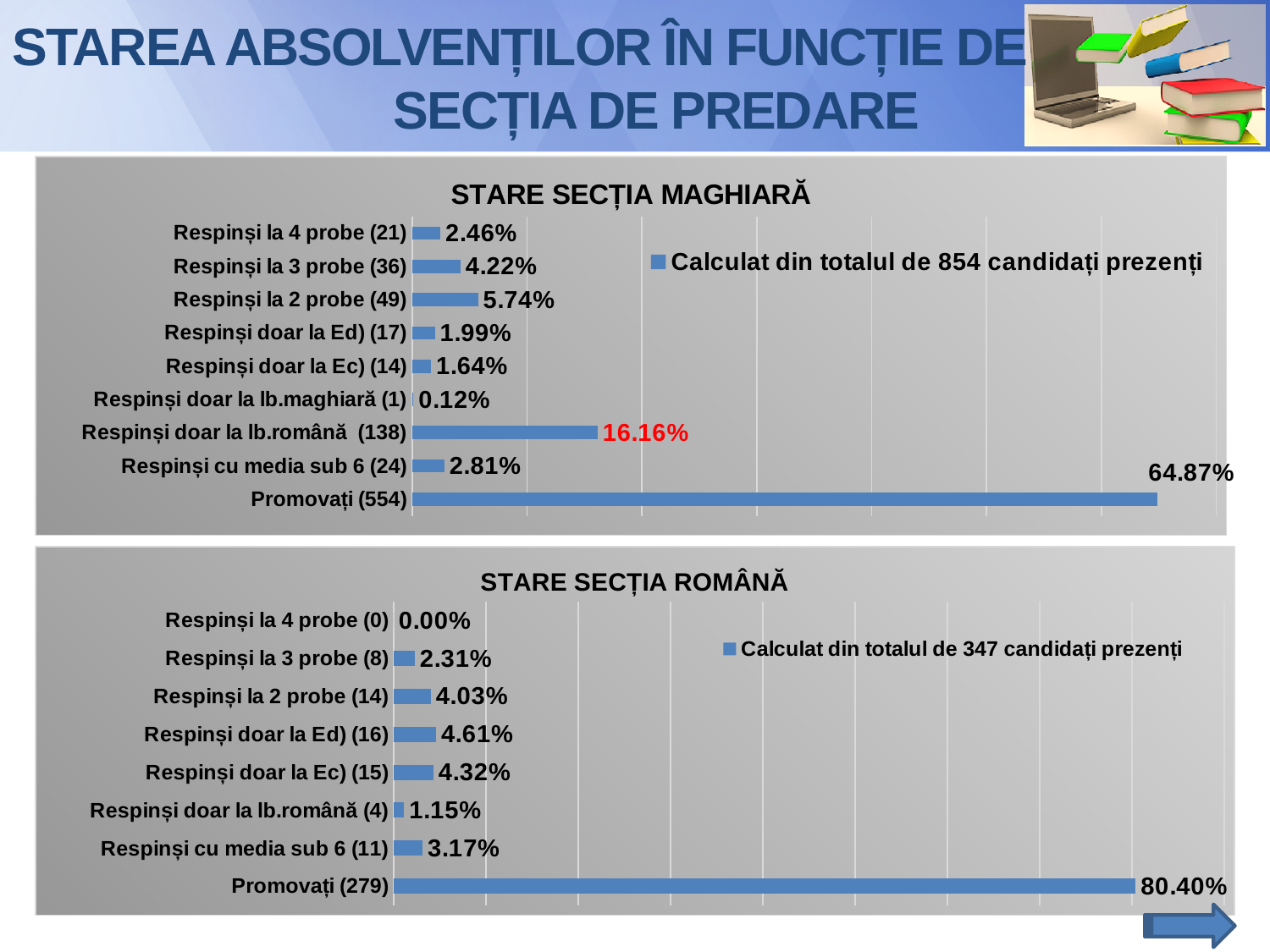
In the STARE SECȚIA ROMÂNĂ chart, which is larger: Respinși doar la Ec) (15) or Respinși cu media sub 6 (11)? Respinși doar la Ec) (15) In the STARE SECȚIA MAGHIARĂ chart, what does the legend entry say? Calculat din totalul de 854 candidați prezenți What type of chart is the STARE SECȚIA ROMÂNĂ chart? Bar chart In the STARE SECȚIA ROMÂNĂ chart, what is the value for Promovați (279)? 80.40% In the STARE SECȚIA ROMÂNĂ chart, how many series does the legend list? 1 In the STARE SECȚIA MAGHIARĂ chart, what is the value for Promovați (554)? 64.87% In the STARE SECȚIA MAGHIARĂ chart, what is the difference between Respinși la 2 probe (49) and Respinși la 3 probe (36)? 1.52% In the STARE SECȚIA MAGHIARĂ chart, which category has the lowest value? Respinși doar la lb.maghiară (1) In the STARE SECȚIA ROMÂNĂ chart, which category has the highest value? Promovați (279) In the STARE SECȚIA MAGHIARĂ chart, how many categories are shown? 9 In the STARE SECȚIA ROMÂNĂ chart, what is the value for Respinși doar la Ed) (16)? 4.61% In the STARE SECȚIA MAGHIARĂ chart, what is the value for Respinși doar la lb.română (138)? 16.16%